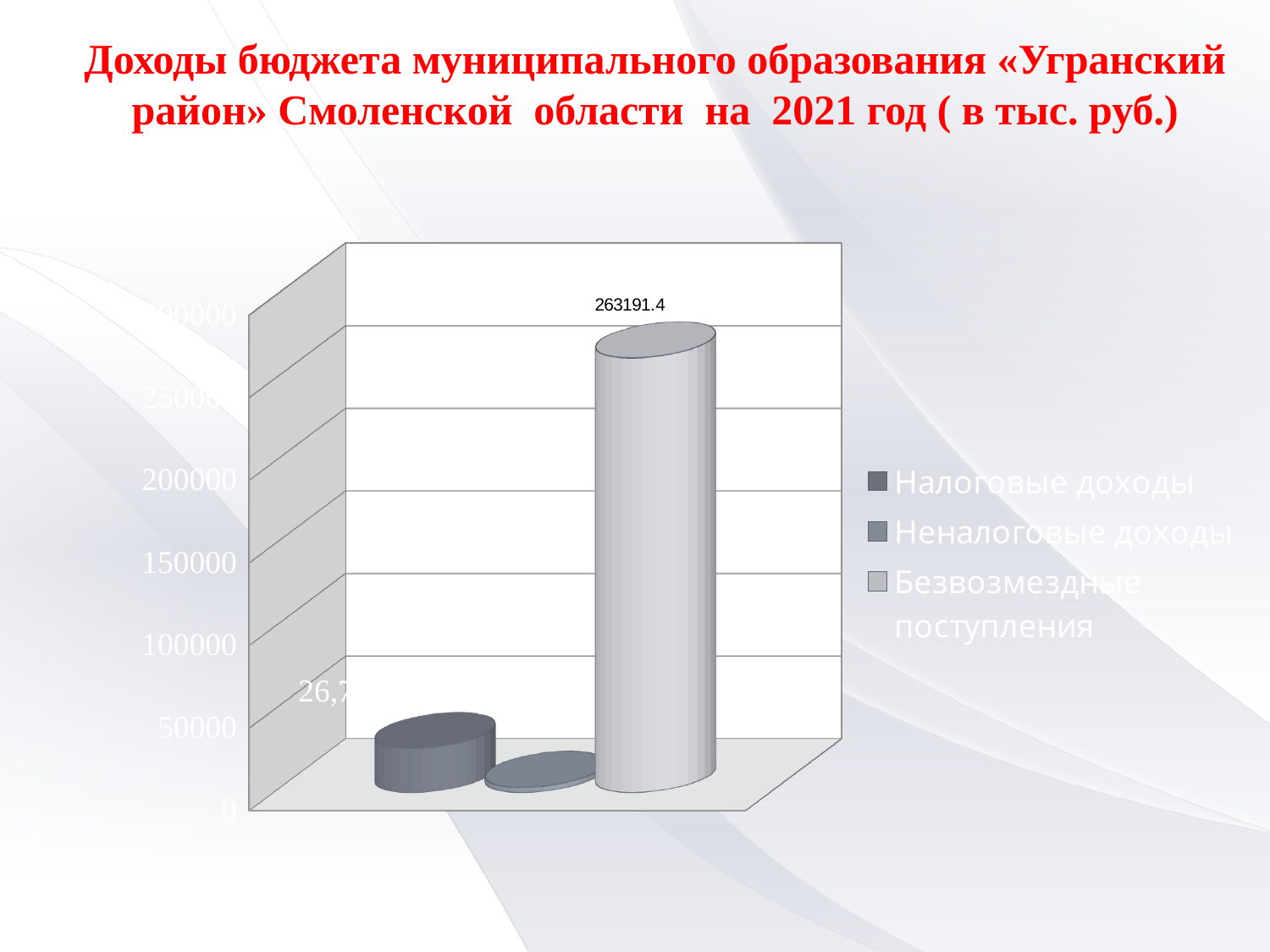
How many bars are plotted on the chart? 3 How many series does the legend list? 3 Which year does the chart title refer to? 2021 Is the value for Неналоговые доходы greater or less than 50000? less What is the value shown for Безвозмездные поступления? 263191.4 Which series has the lowest value? Неналоговые доходы What kind of chart is shown on the slide? bar chart What unit of measurement is stated in the slide title? тыс. руб. Is the value for Налоговые доходы greater or less than 100000? less Which is larger, Налоговые доходы or Неналоговые доходы? Налоговые доходы Which series has the highest value? Безвозмездные поступления Is the value for Безвозмездные поступления greater or less than 250000? greater